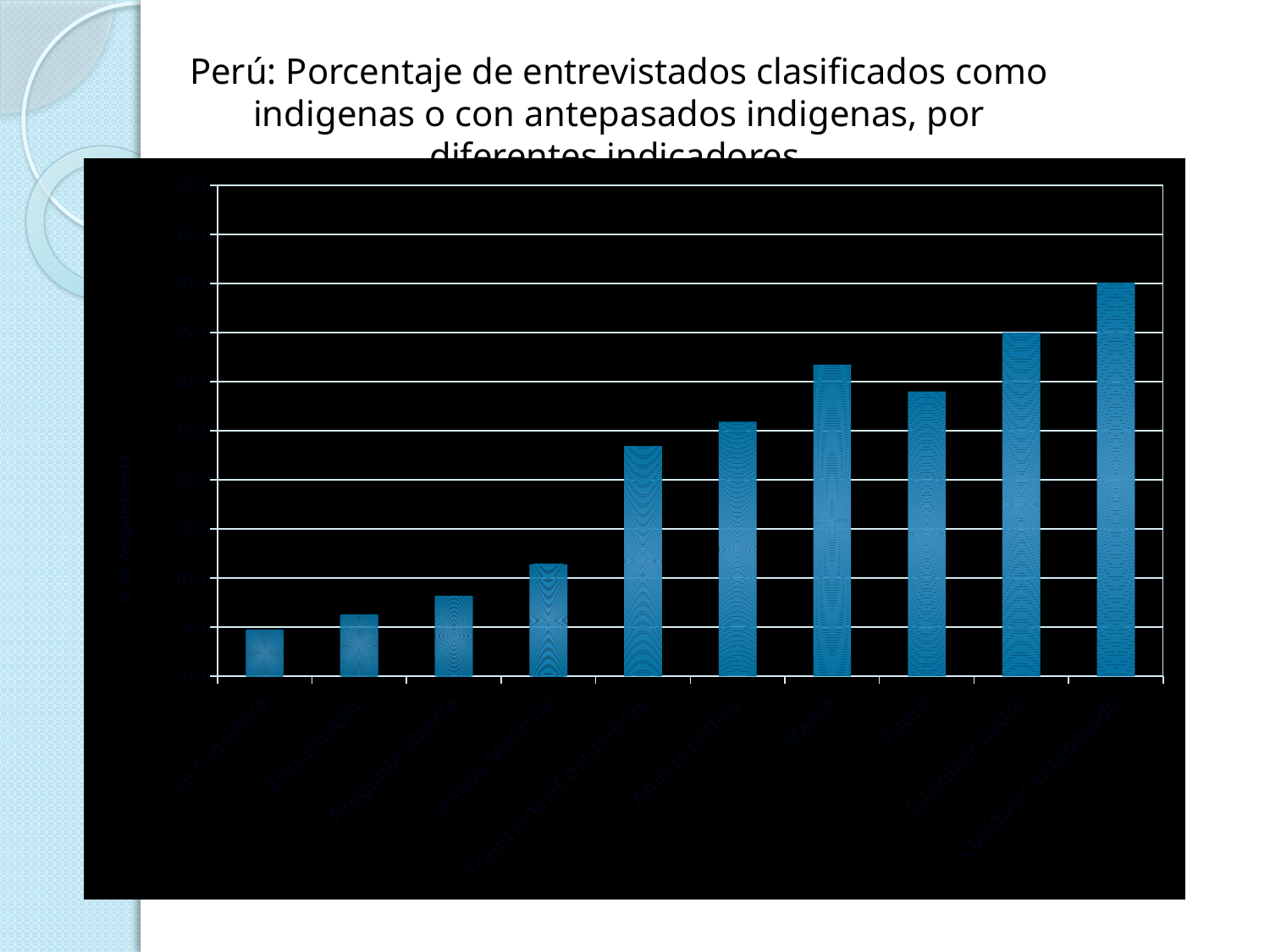
Which category has the highest value? Cualquier antepasado Is the value for Lengua Materna greater or less than 10? greater Is the value for Padre greater or less than 30? less Do the values generally rise or fall from left to right along the x axis? rise Which category has the lowest value? Se considera Is the value for Madre greater or less than 30? greater How many categories (bars) does the chart show? 10 What kind of chart is shown on the slide? bar chart Which is larger, the value for Encuestador or the value for Pregunta abierta? Pregunta abierta Which is larger, the value for Madre or the value for Padre? Madre